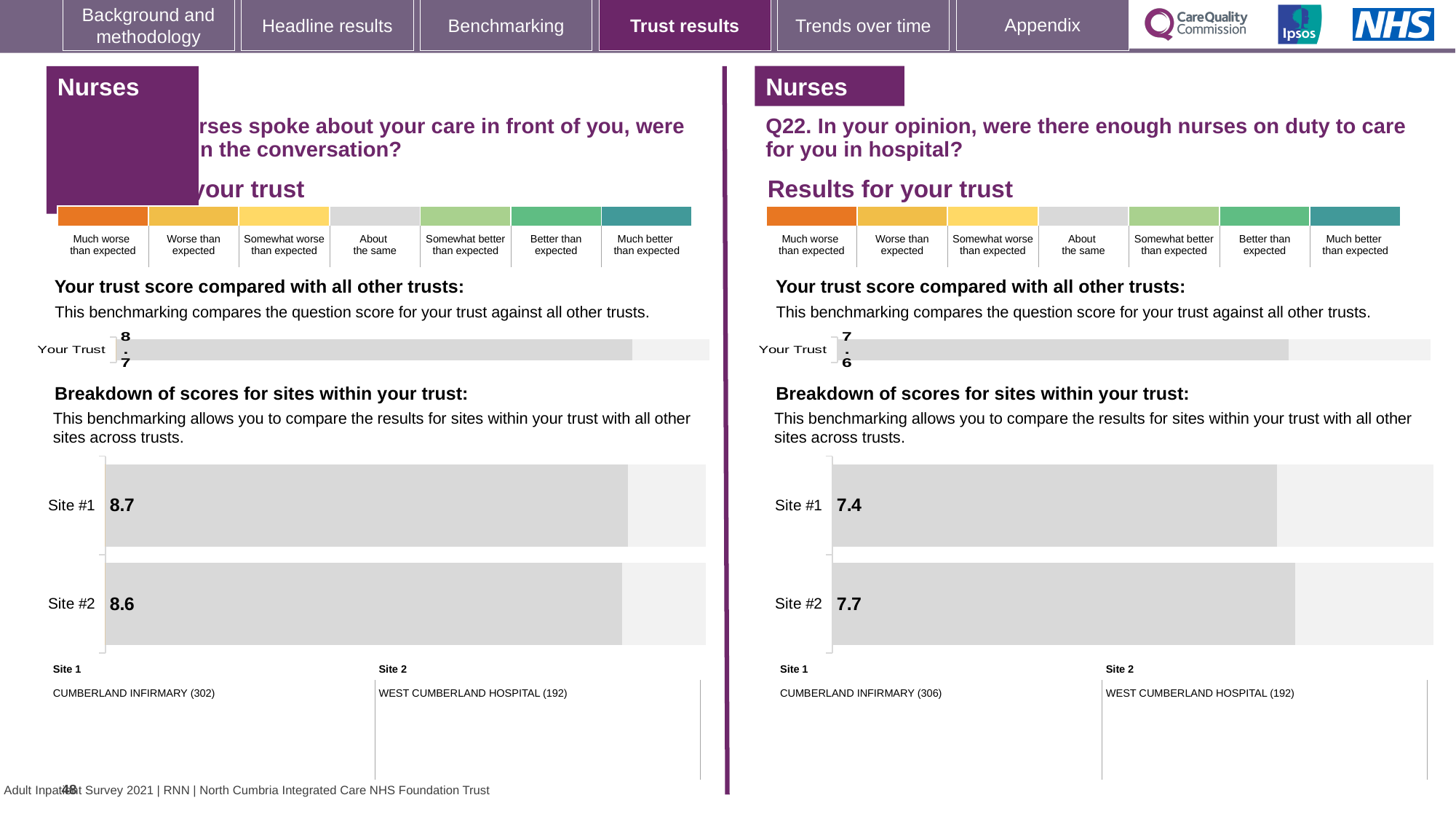
In the site breakdown chart on the left half of the slide, what is the score for Site #1? 8.7 In the site breakdown chart on the left half of the slide, which site has the lower score? Site #2 On the right half of the slide (Q22), what is the score shown for Your Trust in the trust score bar chart? 7.6 How many sites are shown in the site breakdown chart on the right half of the slide (Q22)? 2 In the site breakdown chart on the right half of the slide (Q22), what is the score for Site #1? 7.4 What type of chart is used to show the site breakdown scores on the slide? Bar chart In the site breakdown chart on the left half of the slide, what is the score for Site #2? 8.6 In the site breakdown chart on the left half of the slide, what is the difference between the Site #1 and Site #2 scores? 0.1 In the site breakdown chart on the right half of the slide (Q22), which site has the higher score? Site #2 On the left half of the slide, what is the score shown for Your Trust in the trust score bar chart? 8.7 In the site breakdown chart on the right half of the slide (Q22), what is the difference between the Site #2 and Site #1 scores? 0.3 In the site breakdown chart on the right half of the slide (Q22), what is the score for Site #2? 7.7